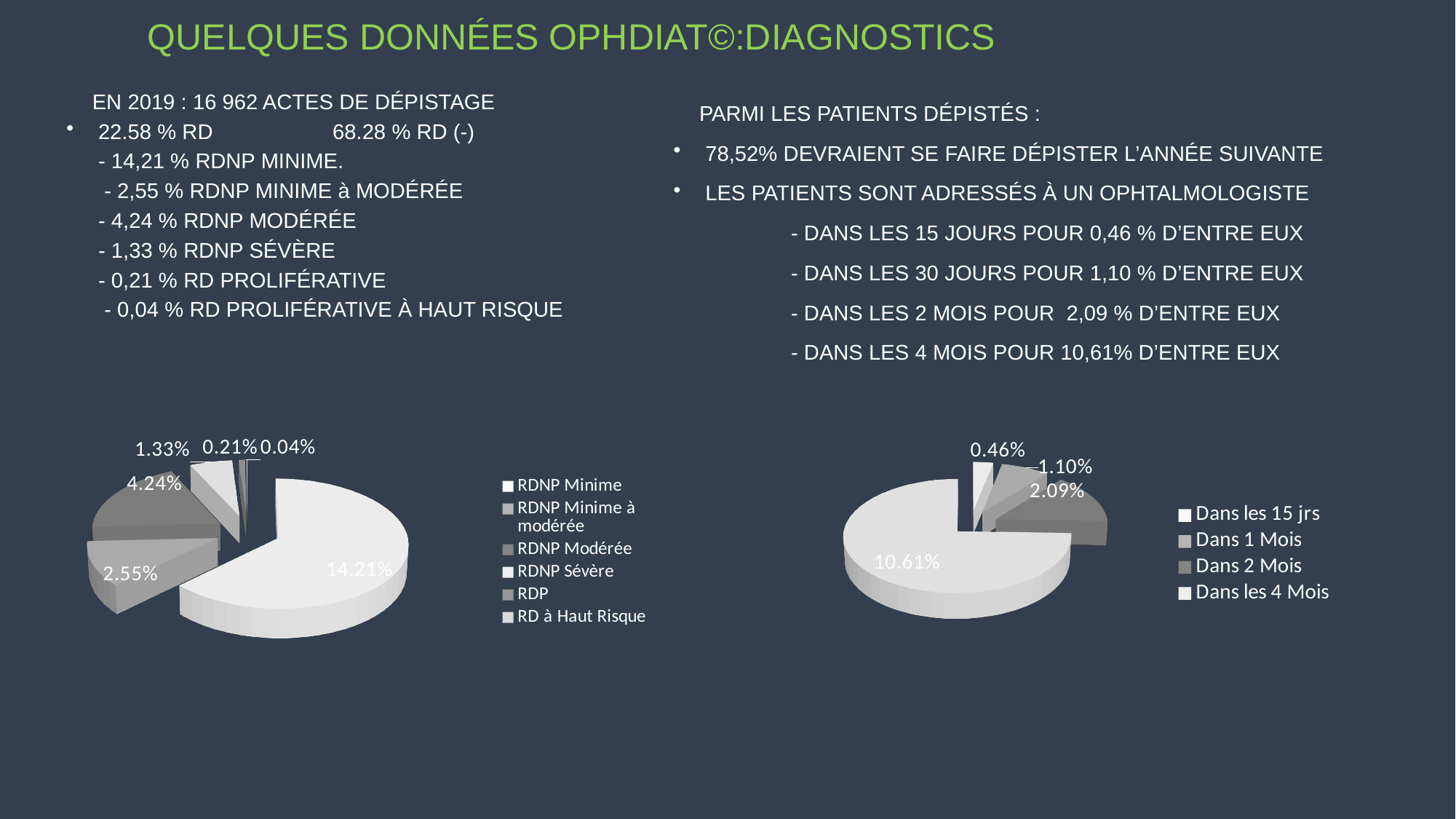
In the right pie chart, what is the value for Dans les 15 jrs? 0.46% In the left pie chart, which category has the largest slice? RDNP Minime In the left pie chart, which category has the smallest slice? RD à Haut Risque How many categories does the legend of the right pie chart list? 4 In the left pie chart, what is the value for RD à Haut Risque? 0.04% In the left pie chart, what is the value for RDNP Minime? 14.21% What type of chart is the chart on the left of the slide? pie chart In the right pie chart, which is larger: Dans 1 Mois or Dans 2 Mois? Dans 2 Mois In the right pie chart, what is the value for Dans les 4 Mois? 10.61% How many categories does the legend of the left pie chart list? 6 In the left pie chart, what is the difference between the values for RDNP Modérée and RDNP Sévère? 2.91% In the left pie chart, what is the value for RDNP Modérée? 4.24%